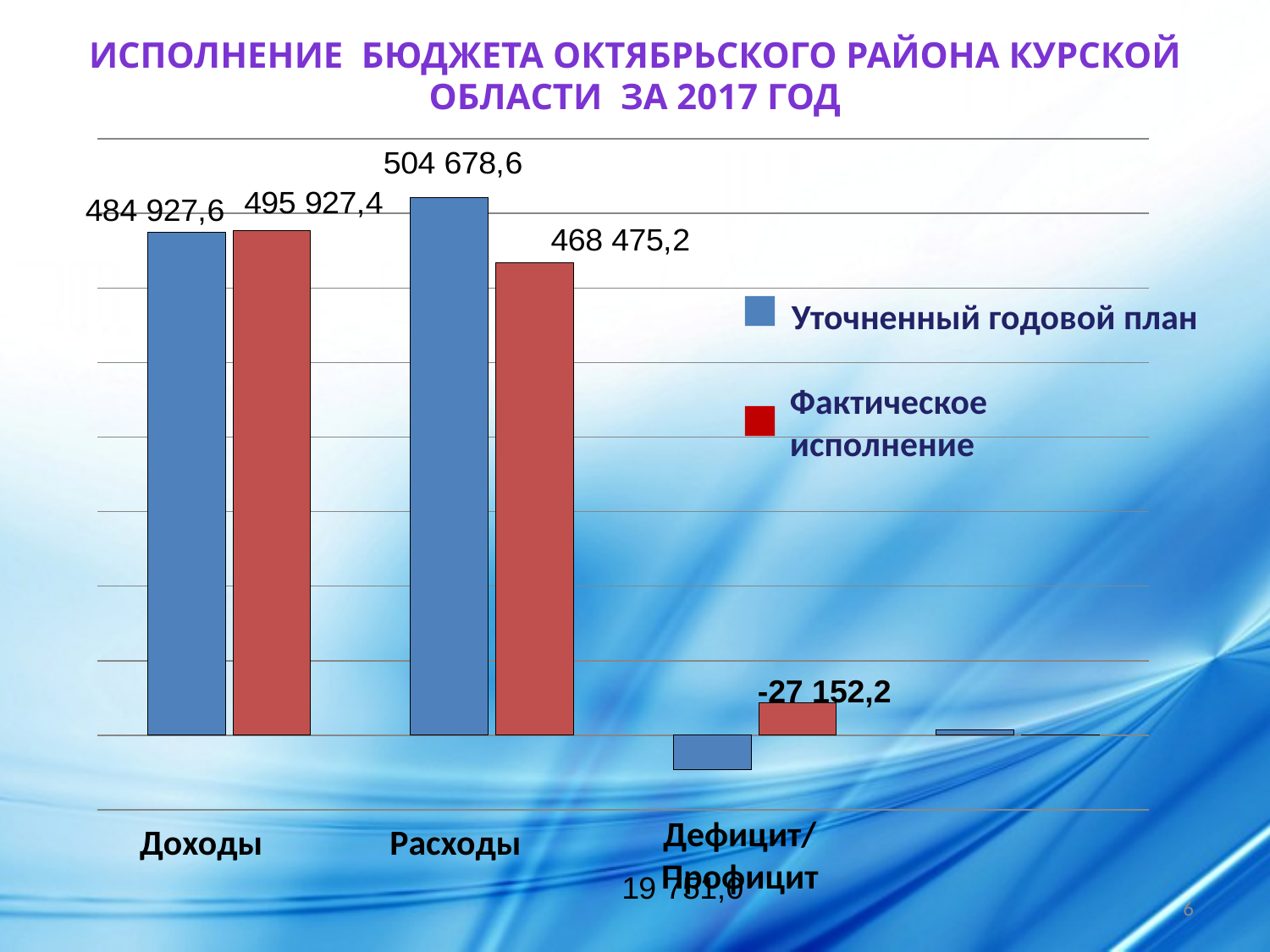
What kind of chart is shown on the slide? Bar chart What is the value of Уточненный годовой план for Доходы? 484 927,6 What is the value of Фактическое исполнение for Доходы? 495 927,4 What is the value of Фактическое исполнение for Расходы? 468 475,2 What is the difference between Уточненный годовой план and Фактическое исполнение for Расходы? 36 203,4 For Расходы, which series has the larger value: Уточненный годовой план or Фактическое исполнение? Уточненный годовой план For Доходы, which series has the larger value: Уточненный годовой план or Фактическое исполнение? Фактическое исполнение How many series does the legend list? 2 By how much does Фактическое исполнение exceed Уточненный годовой план for Доходы? 10 999,8 What is the value of Уточненный годовой план for Расходы? 504 678,6 Which category has the highest Уточненный годовой план value? Расходы What value is labelled on the Фактическое исполнение bar for Дефицит/Профицит? -27 152,2